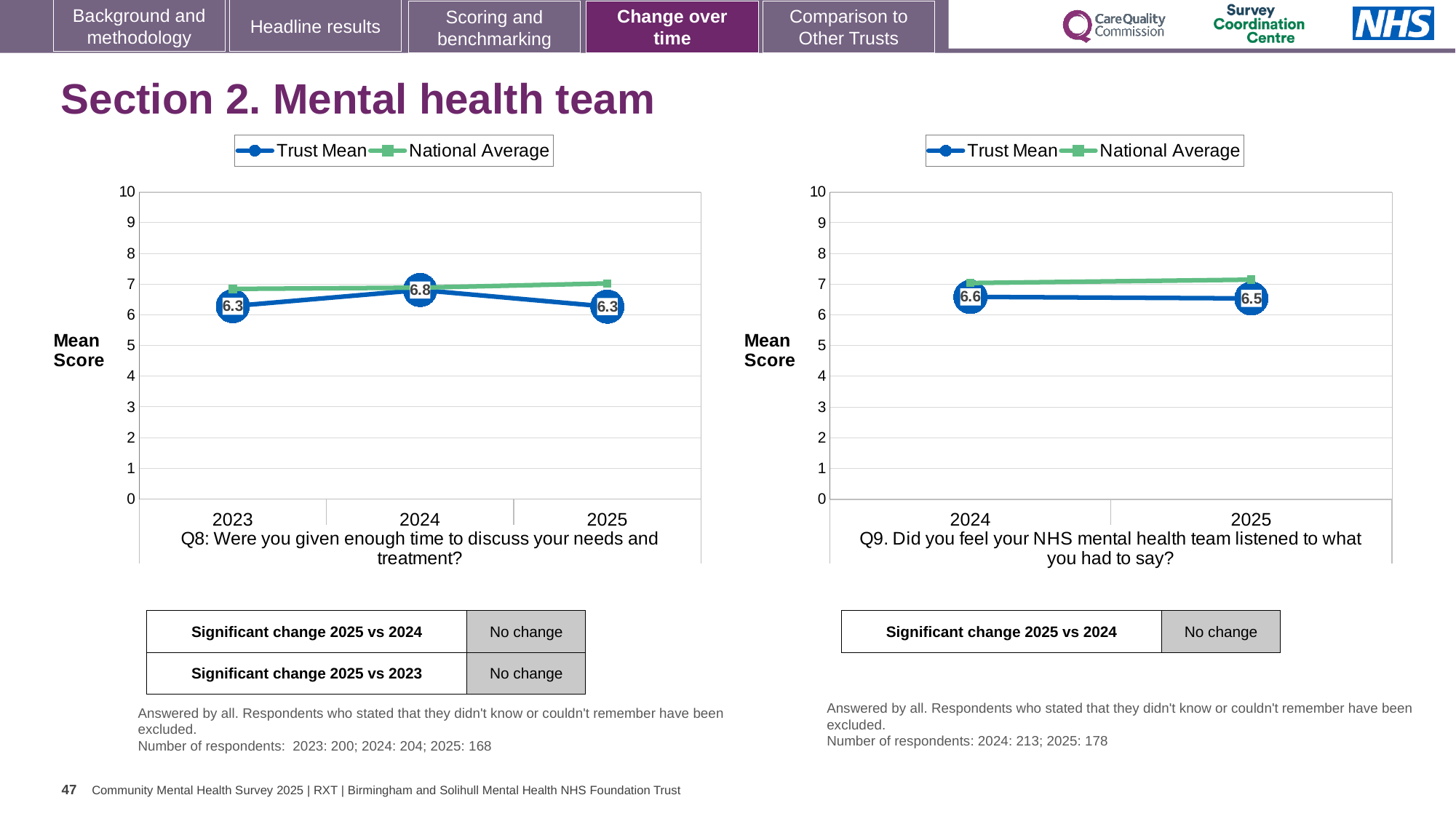
In the Q9 chart (right), what is the Trust Mean for 2025? 6.5 In the Q8 chart (left), what is the Trust Mean for 2023? 6.3 What type of chart is used for Q9 (right)? Line chart In the Q9 chart (right), what is the difference between the Trust Mean in 2024 and in 2025? 0.1 In the Q8 chart (left), which year has the highest Trust Mean? 2024 How many series does the legend of the Q9 chart (right) list? 2 In the Q8 chart (left), is the National Average for 2023 greater or less than 6? greater In the Q9 chart (right), is the Trust Mean higher in 2024 or in 2025? 2024 How many years are shown on the x axis of the Q8 chart (left)? 3 In the Q8 chart (left), what is the Trust Mean for 2024? 6.8 In the Q8 chart (left), what is the difference between the Trust Mean in 2024 and in 2025? 0.5 In the Q9 chart (right), what is the Trust Mean for 2024? 6.6